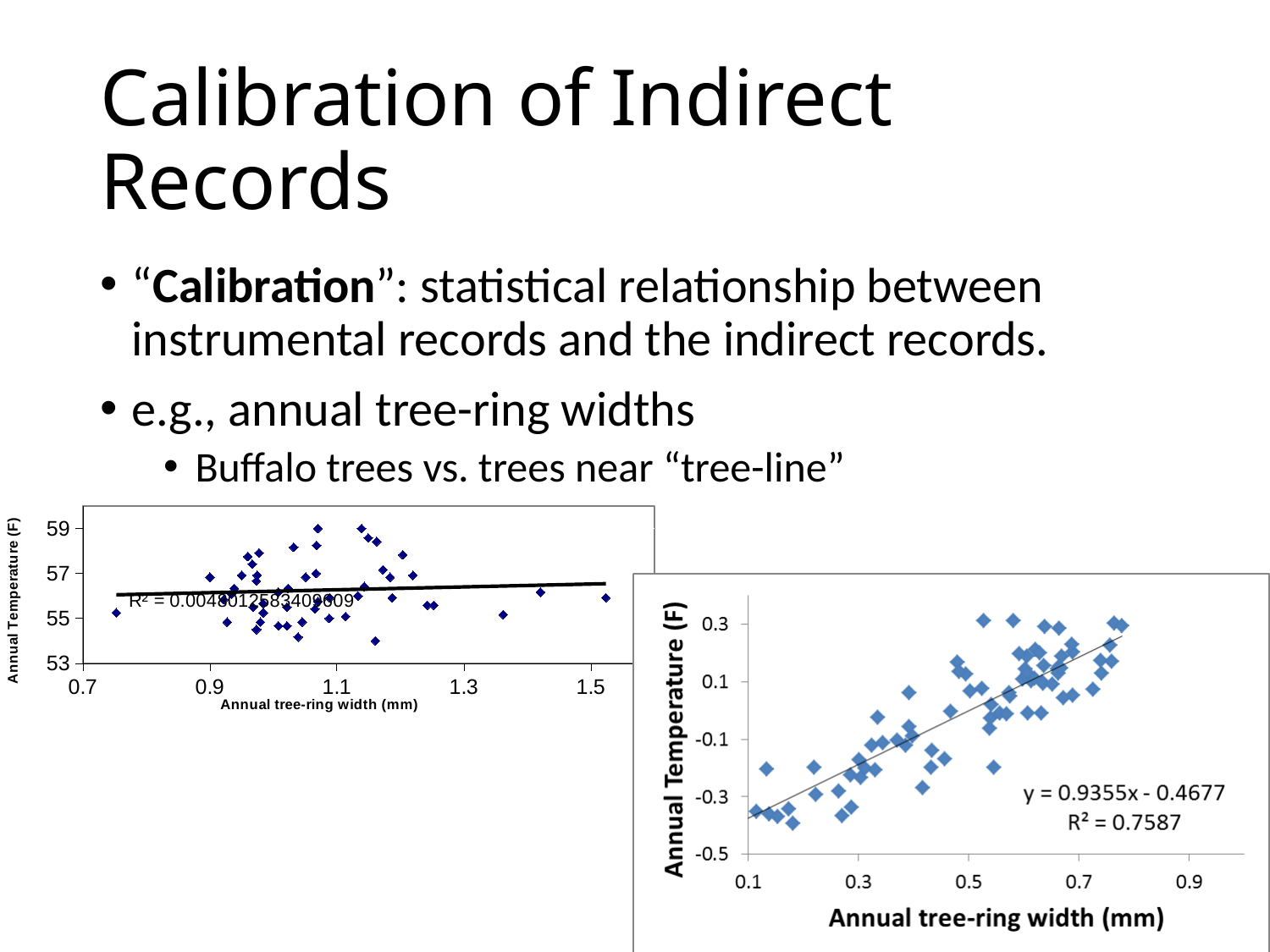
In the right-hand chart, what is the R² value shown? R² = 0.7587 In the right-hand chart, does annual temperature rise or fall as annual tree-ring width increases? rise In the right-hand chart, what is the intercept of the fitted trendline? -0.4677 In the right-hand chart, what is the trendline equation shown? y = 0.9355x - 0.4677 How many charts are shown on the slide? 2 In the right-hand chart, what is the label of the x axis? Annual tree-ring width (mm) What kind of chart is the chart on the right of the slide? scatter chart In the left-hand chart, what is the highest tick value shown on the y axis? 59 In the right-hand chart, what is the label of the y axis? Annual Temperature (F) In the right-hand chart, what is the lowest tick value shown on the y axis? -0.5 In the right-hand chart, what is the slope of the fitted trendline? 0.9355 Which chart shows the stronger relationship between tree-ring width and temperature, the left-hand chart or the right-hand chart? the right-hand chart